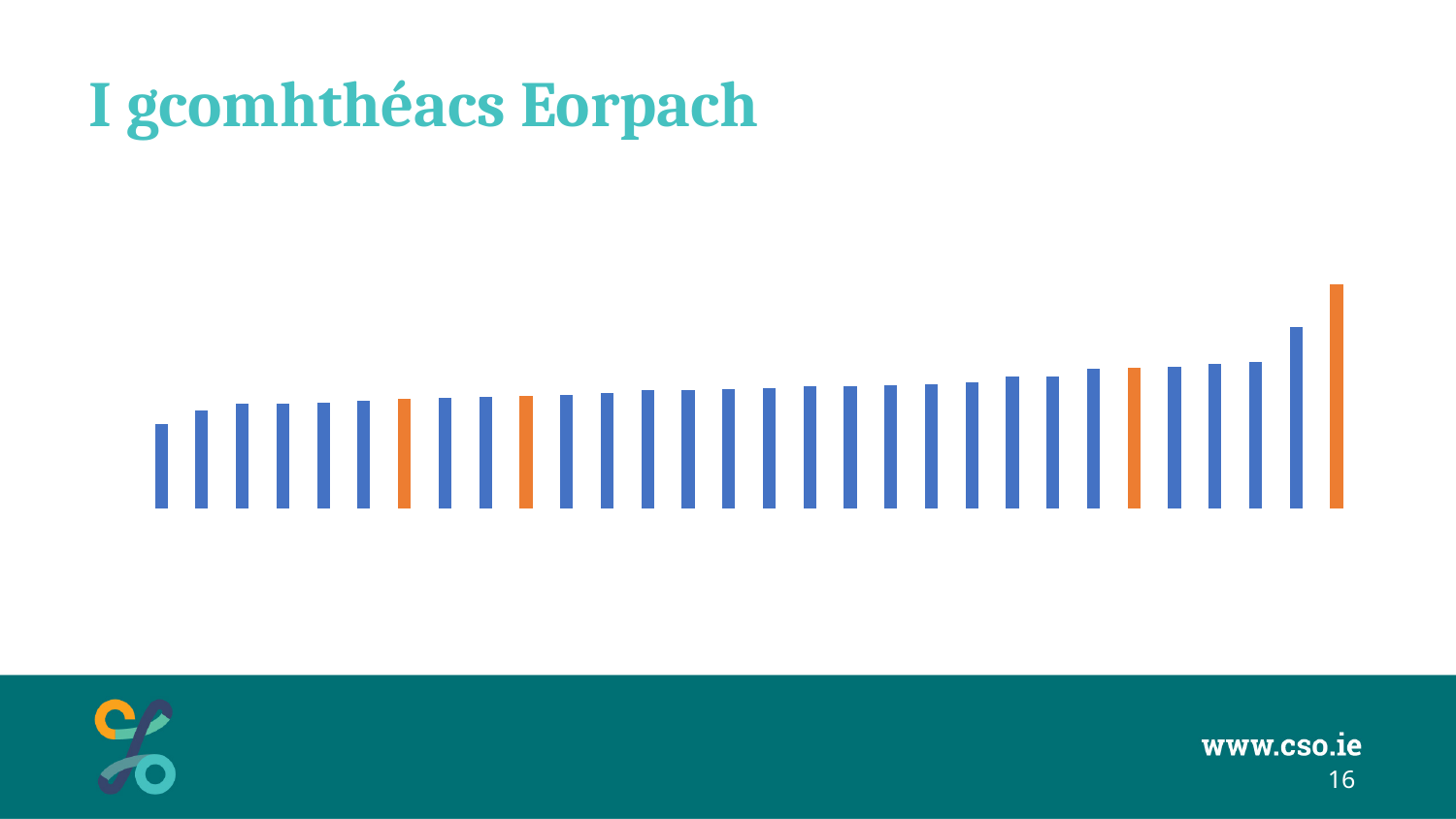
Is the rightmost bar taller or shorter than the leftmost bar? taller How many bars in the chart are coloured orange? 4 Is the second bar from the right taller or shorter than the rightmost bar? shorter How many bars are plotted in the chart? 30 Is the shortest bar in the chart at the left end or the right end? left end Is the tallest bar in the chart at the left end or the right end? right end What colour is the tallest bar in the chart? orange What kind of chart is shown on the slide? bar chart Do the bar values generally rise or fall from left to right across the chart? rise